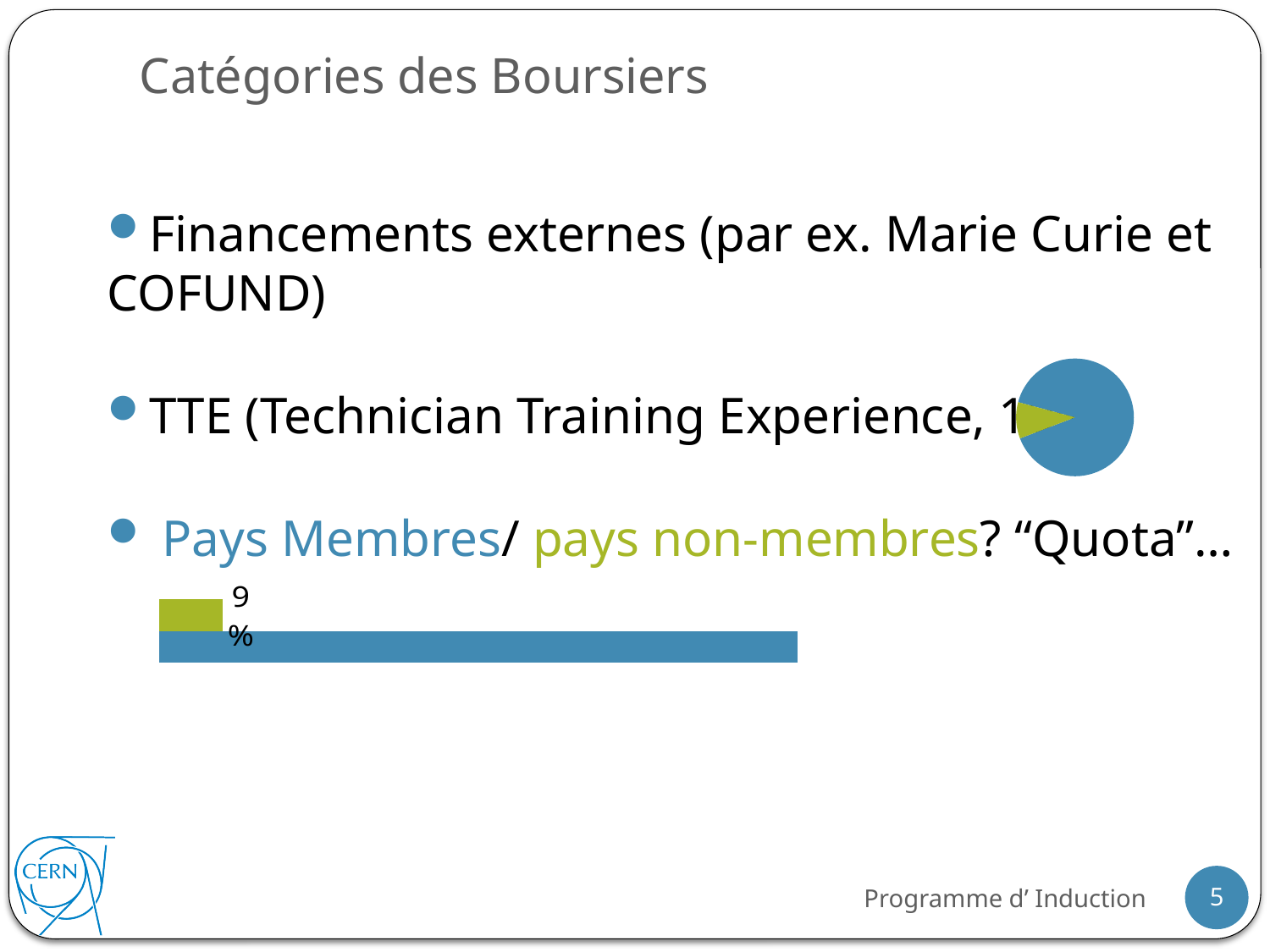
What kind of chart is shown at the bottom left of the slide, below the 'Pays Membres / pays non-membres' bullet? bar chart In the bar chart at the bottom of the slide, are the bars horizontal or vertical? horizontal In the pie chart at the top right, how many slices are there? 2 In the pie chart at the top right, what colour is the smaller slice? green In the pie chart at the top right, which slice is larger, the blue one or the green one? the blue one In the bar chart at the bottom of the slide, which bar is the shortest? the green bar In the bar chart at the bottom of the slide, what value is printed next to the green bar? 9% In the bar chart at the bottom of the slide, which bar is longer, the blue one or the green one? the blue one What kind of chart is shown at the top right of the slide? pie chart In the bar chart at the bottom of the slide, how many bars are there? 2